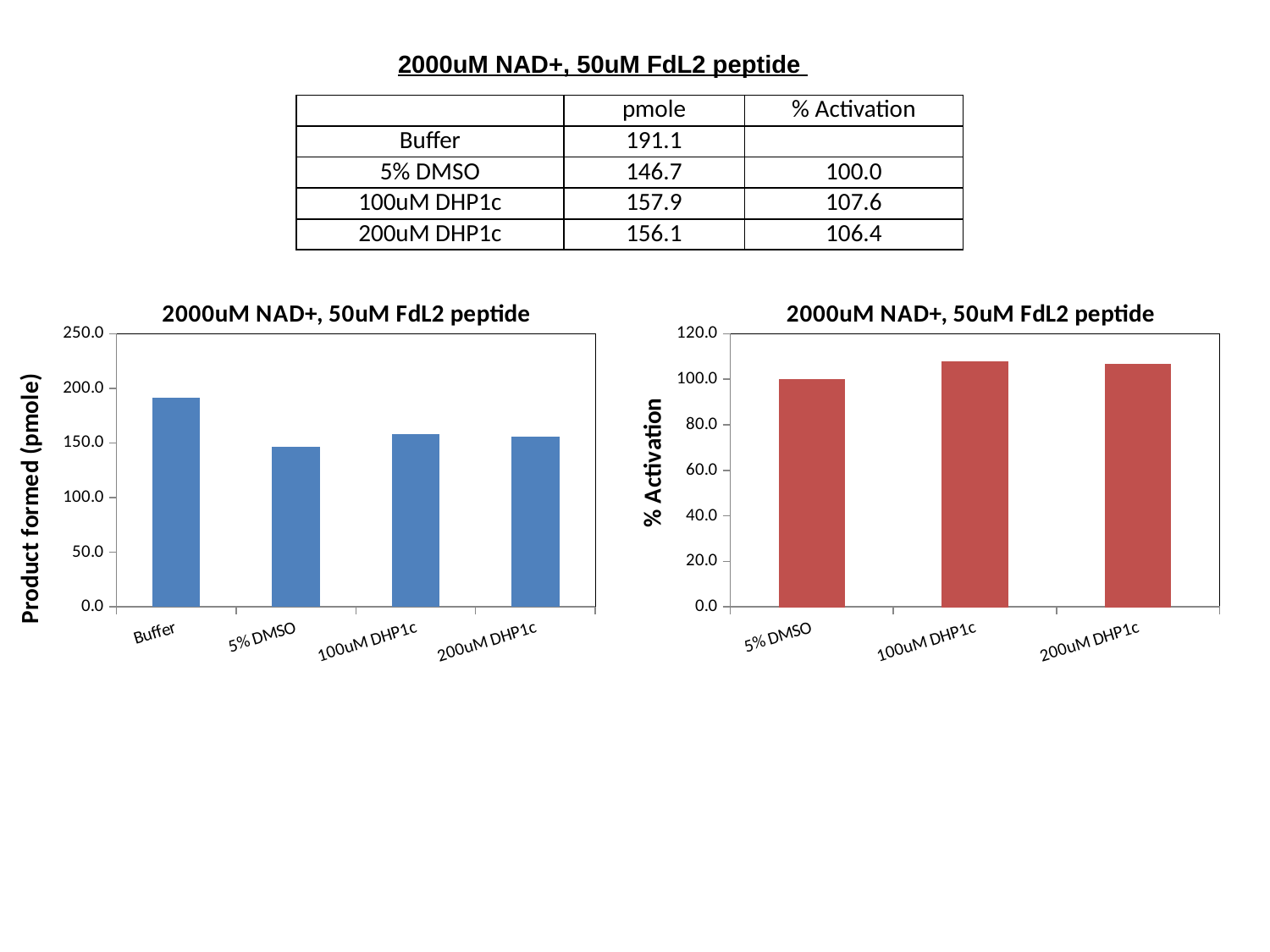
On the left chart, what is the product formed (pmole) for Buffer? 191.1 On the right chart, what is the % Activation for 200uM DHP1c? 106.4 On the left chart, is the value for Buffer greater or less than 150.0? greater On the left chart, which category has the highest product formed? Buffer How many categories are shown on the left chart? 4 On the left chart, what is the product formed (pmole) for 5% DMSO? 146.7 What kind of chart is the right chart? Bar chart On the left chart, which category has the lowest product formed? 5% DMSO On the right chart, what is the % Activation for 100uM DHP1c? 107.6 On the right chart, which category has the lowest % Activation? 5% DMSO On the left chart, what is the difference in product formed between Buffer and 5% DMSO? 44.4 On the right chart, is the value for 100uM DHP1c greater or less than 100.0? greater